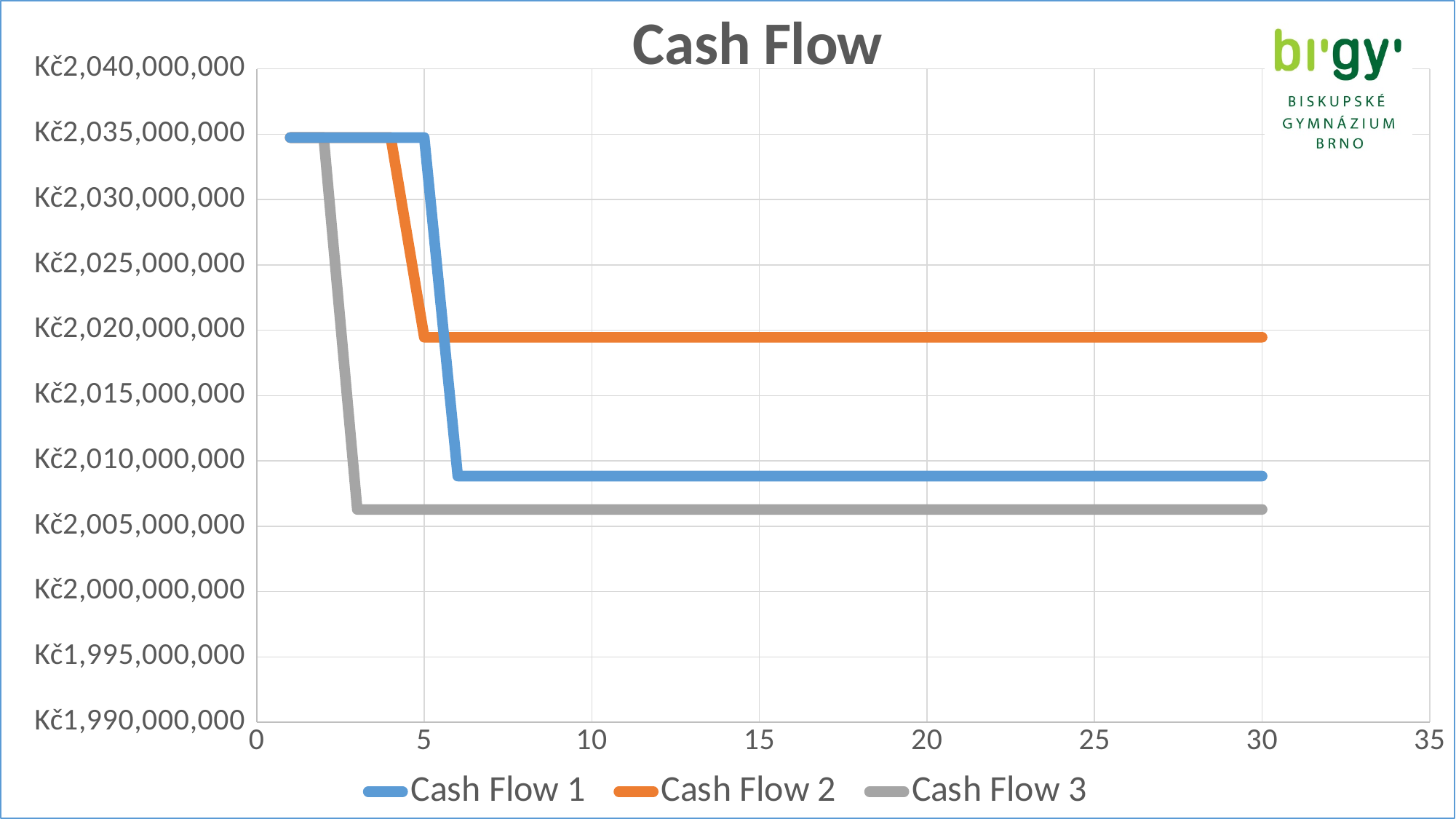
Which series has the highest value at x = 30? Cash Flow 2 What is the title of the chart? Cash Flow Is the value for Cash Flow 3 at x = 30 greater or less than Kč2,005,000,000? greater At x = 30, which is larger: Cash Flow 1 or Cash Flow 3? Cash Flow 1 What kind of chart is shown on the slide? line chart Do the values for Cash Flow 1 rise or fall overall from left to right along the x axis? fall How many series does the legend list? 3 Is the value for Cash Flow 1 at x = 30 greater or less than Kč2,010,000,000? less Is the value for Cash Flow 1 at x = 1 greater or less than Kč2,030,000,000? greater Which series has the lowest value at x = 30? Cash Flow 3 At x = 30, which is larger: Cash Flow 1 or Cash Flow 2? Cash Flow 2 Which colour is used for the Cash Flow 2 line? orange